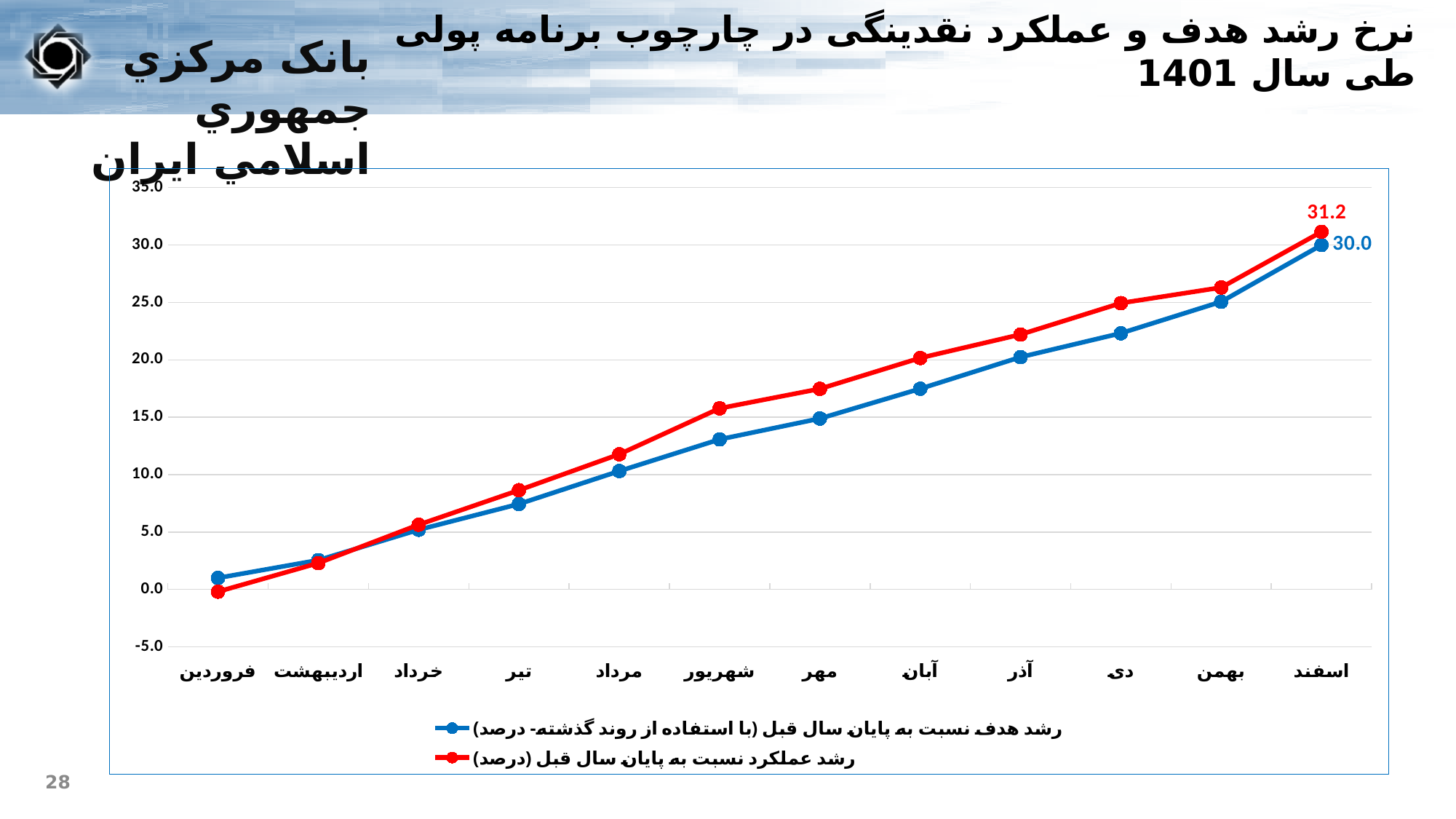
Which colour is used for the series رشد عملکرد نسبت به پایان سال قبل (درصد)? red What is the difference between the red and blue series values for اسفند? 1.2 Do the values of both series rise or fall from فروردین to اسفند? rise What is the value of the blue series (رشد هدف نسبت به پایان سال قبل) for اسفند? 30.0 Is the value of the blue series for تیر greater or less than 10.0? less How many months are shown on the x axis? 12 In which month does the red series reach its highest value? اسفند How many series does the legend list? 2 Is the value of the red series for مرداد greater or less than 10.0? greater What is the value of the red series (رشد عملکرد نسبت به پایان سال قبل) for اسفند? 31.2 What type of chart is shown on the slide? line chart For اسفند, which series has the larger value, the red (عملکرد) or the blue (هدف)? red (عملکرد)